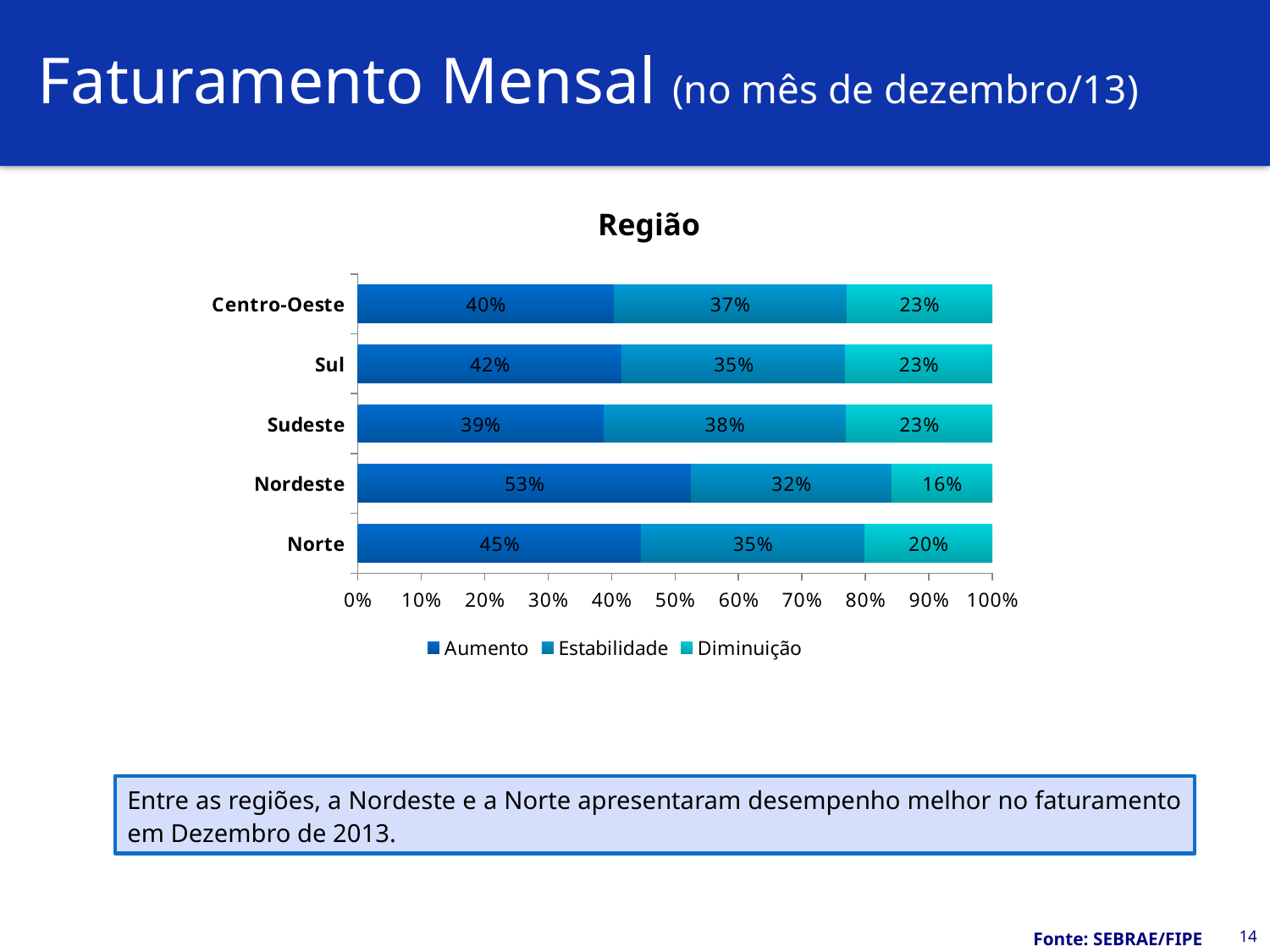
Which is larger, the Aumento value for Sul or the Aumento value for Centro-Oeste? Sul What is the Estabilidade value for Sudeste? 38% What is the total of the stacked bar for Norte? 100% What is the Aumento value for Nordeste? 53% What kind of chart is shown on the slide? Stacked bar chart How many series does the legend list? 3 What is the title of the chart? Região What is the difference between the Aumento values for Nordeste and Sudeste? 14% What is the Diminuição value for Norte? 20% How many regions are shown in the chart? 5 Which region has the lowest Diminuição value? Nordeste Which region has the highest Aumento value? Nordeste